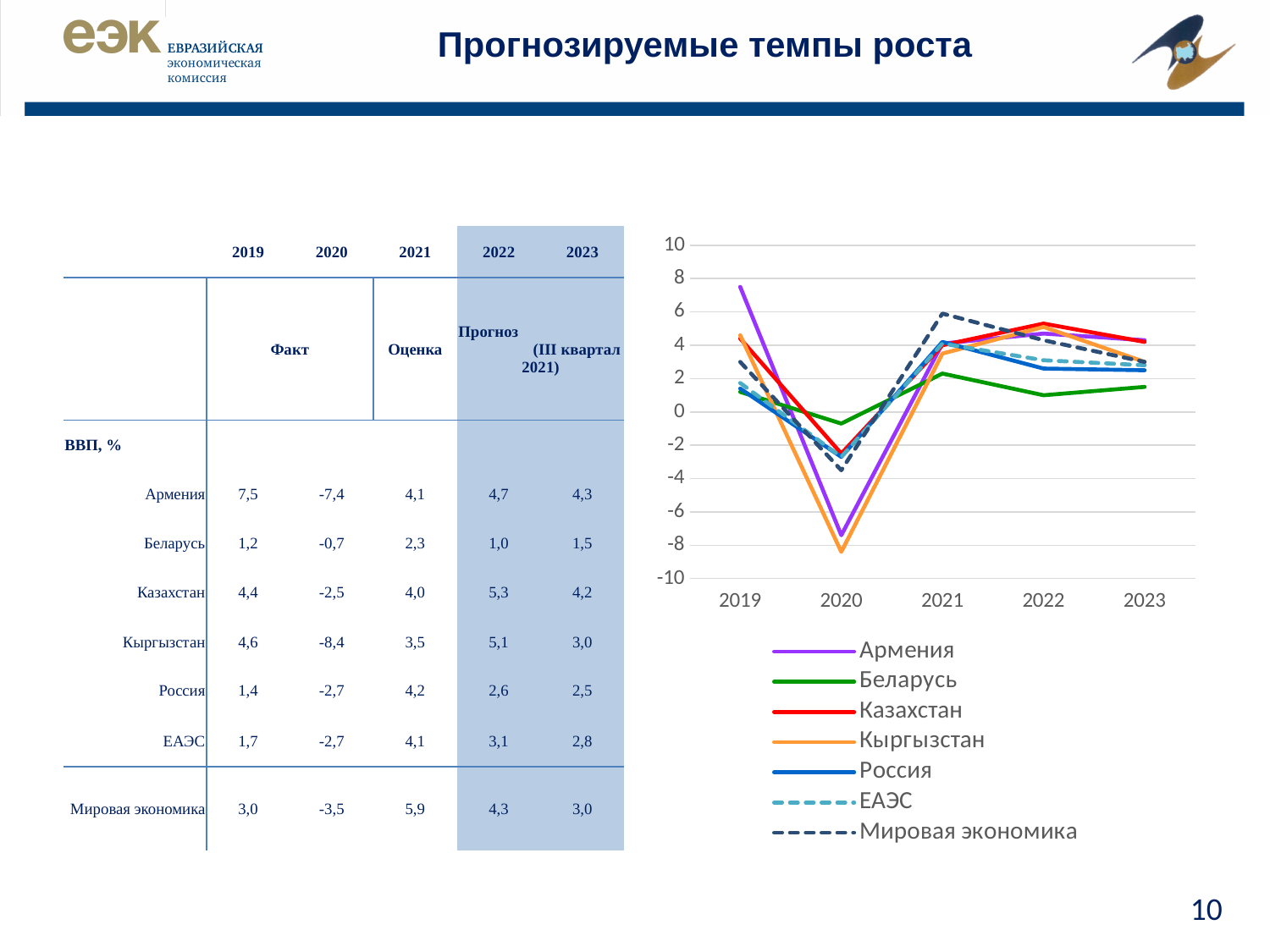
What is the value for Казахстан in 2022? 5,3 How many years are shown along the x axis of the chart? 5 Which two series are drawn with dashed lines in the chart? ЕАЭС and Мировая экономика Is the value for Армения in 2019 greater or less than 6? greater Which series has the highest value in 2021? Мировая экономика Which is larger in 2021: Мировая экономика or Беларусь? Мировая экономика What kind of chart is shown on the slide? line chart How many series does the chart legend list? 7 What is the value for Кыргызстан in 2020? -8,4 What is the difference between the value for Армения in 2019 and in 2020? 14,9 Which series has the highest value in 2019? Армения Which series has the lowest value in 2020? Кыргызстан